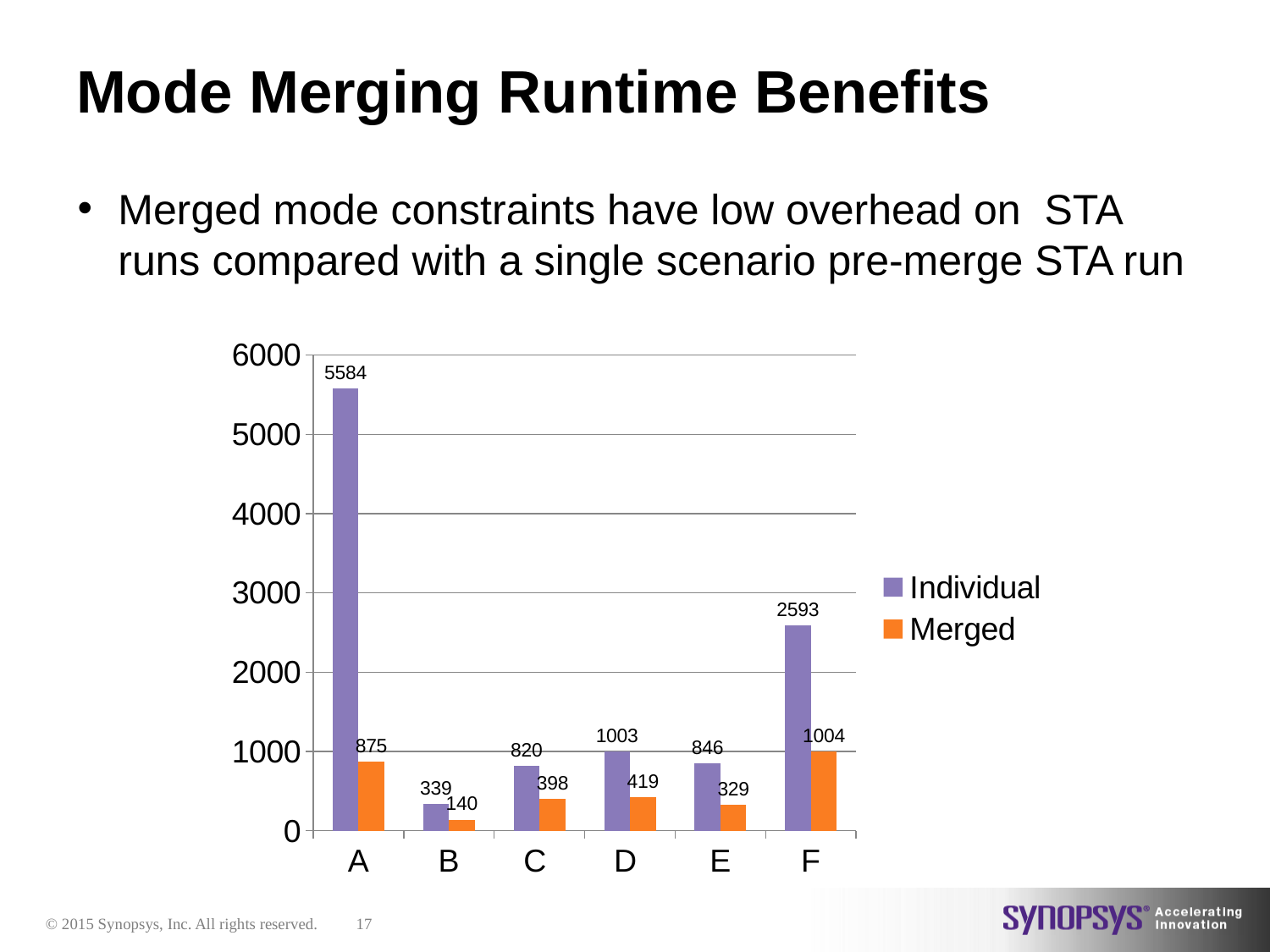
Which is larger, the Merged value for category C or the Merged value for category E? Merged value for category C How many categories are shown on the x axis? 6 Which category has the highest Individual value? A What is the Merged value for category D? 419 What is the Individual value for category A? 5584 Which category has the lowest Merged value? B How many series does the legend list? 2 What kind of chart is shown on the slide? bar chart What is the difference between the Individual and Merged values for category F? 1589 Which series is shown in orange? Merged What is the Individual value for category F? 2593 Is the Individual value for category D greater or less than 1000? greater